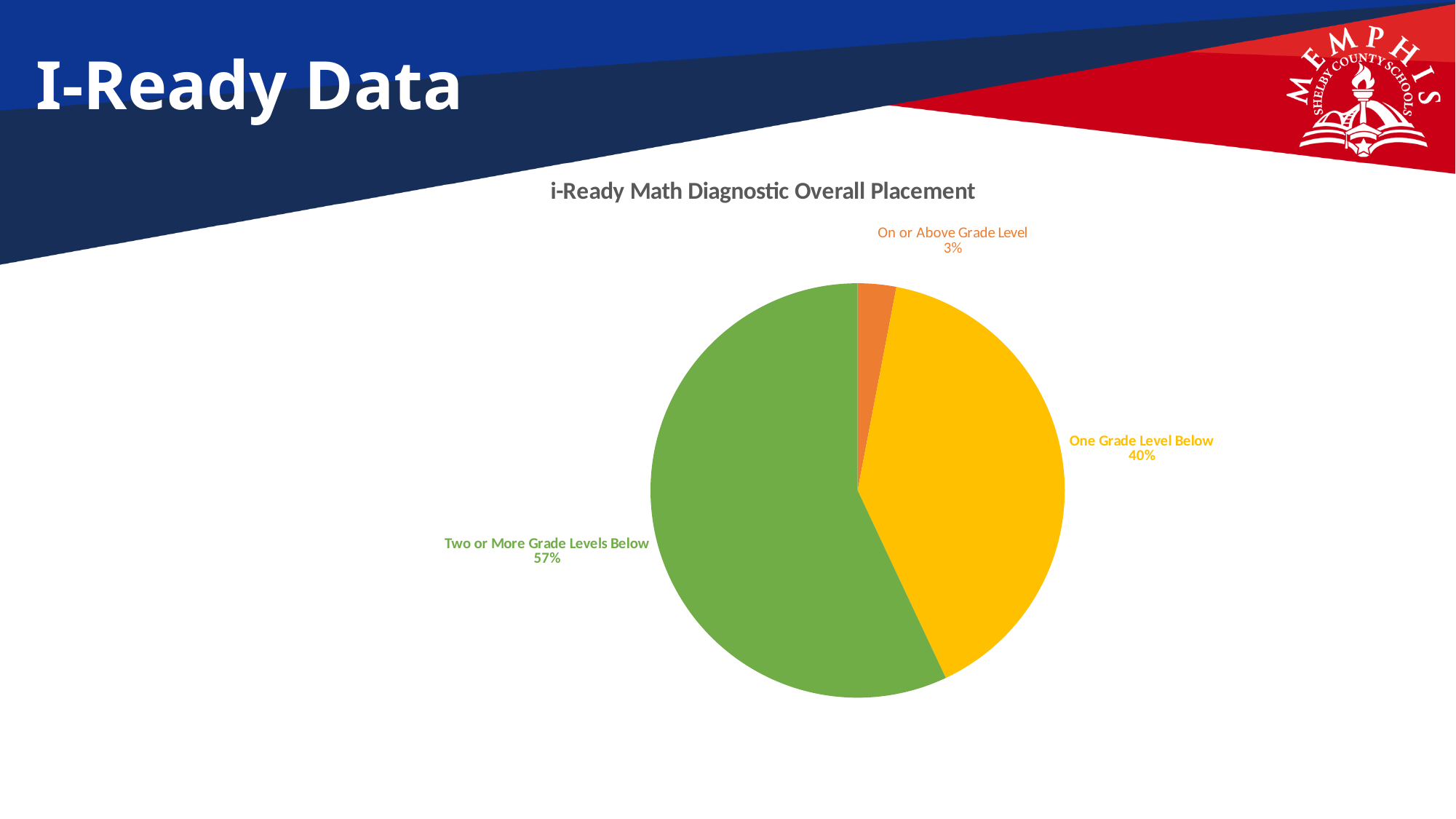
What kind of chart is shown on the slide? Pie chart What is the combined share of students placed below grade level (One Grade Level Below plus Two or More Grade Levels Below)? 97% Which is larger, the share for One Grade Level Below or the share for On or Above Grade Level? One Grade Level Below How many slices does the pie chart have? 3 What is the title of the chart? i-Ready Math Diagnostic Overall Placement Which placement category has the smallest share of the pie? On or Above Grade Level Which placement category has the largest share of the pie? Two or More Grade Levels Below What percentage of students are On or Above Grade Level? 3% What colour is the slice for One Grade Level Below? Yellow What is the difference in percentage points between Two or More Grade Levels Below and One Grade Level Below? 17 What percentage of students are placed One Grade Level Below? 40% What percentage of students are placed Two or More Grade Levels Below? 57%